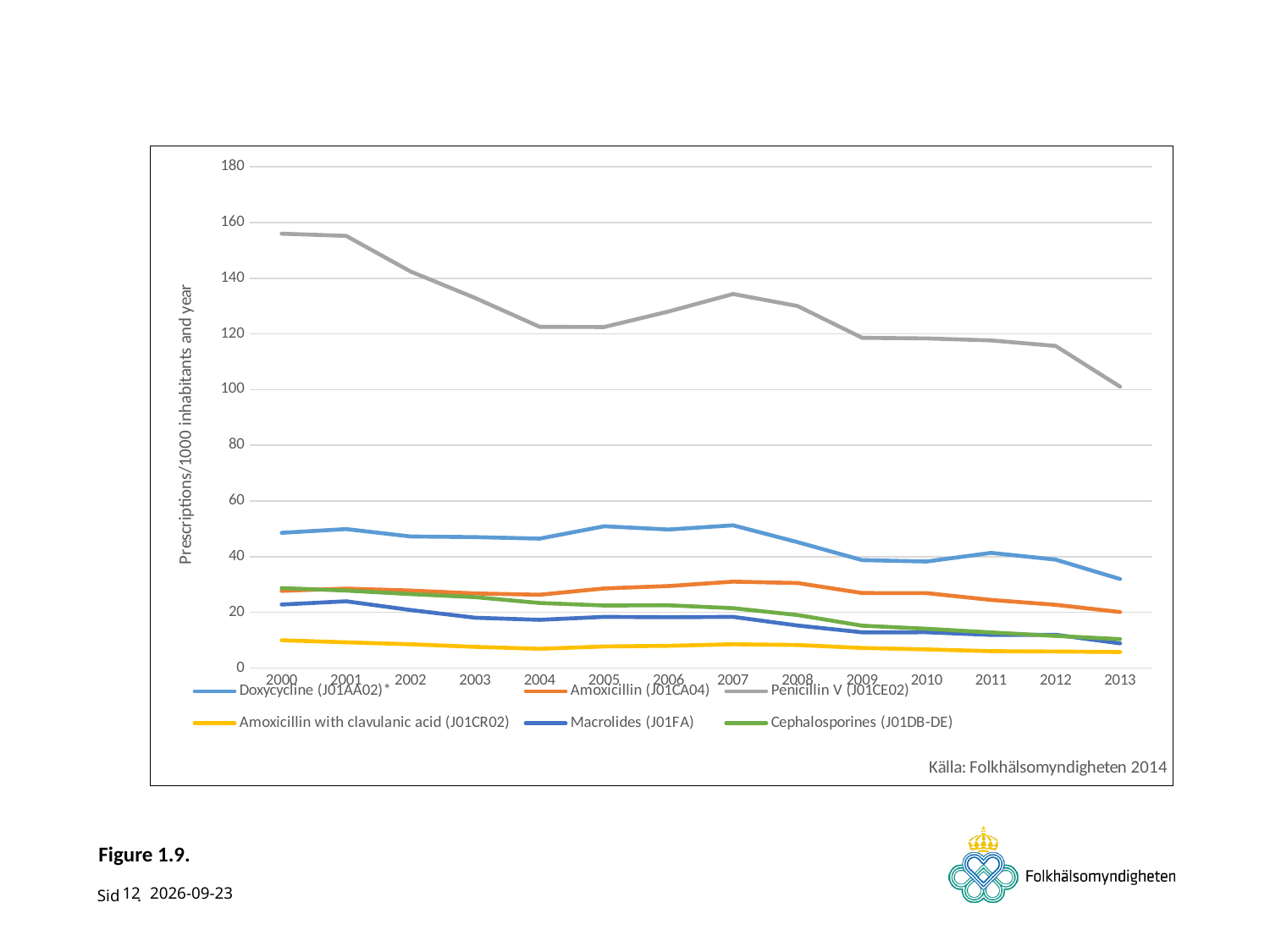
Which series has the lowest values across all years? Amoxicillin with clavulanic acid (J01CR02) What is the label on the y axis? Prescriptions/1000 inhabitants and year Does the Penicillin V (J01CE02) line rise or fall from 2000 to 2013? Fall Is the value for Doxycycline (J01AA02)* in 2007 greater or less than 40? greater Is the value for Penicillin V (J01CE02) in 2013 greater or less than 120? less How many years are shown along the x axis? 14 Which series has the highest values across all years? Penicillin V (J01CE02) Is the value for Penicillin V (J01CE02) in 2000 greater or less than 140? greater What source is cited below the chart? Källa: Folkhälsomyndigheten 2014 How many series does the legend list? 6 In 2013, which is larger: Doxycycline (J01AA02)* or Amoxicillin (J01CA04)? Doxycycline (J01AA02)* What kind of chart is shown on the slide? Line chart